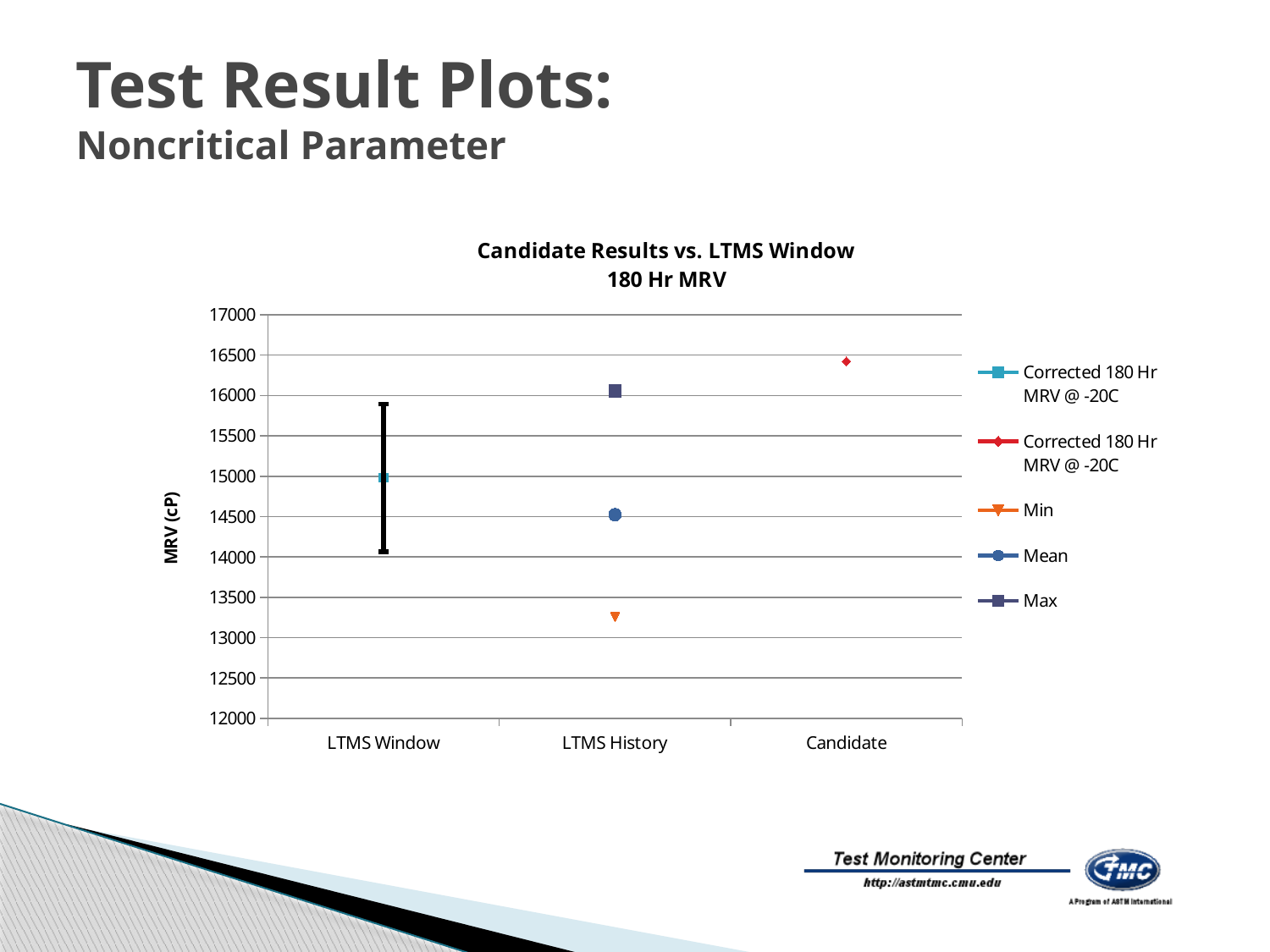
Which is larger, the Candidate value or the Max value for LTMS History? Candidate Is the Max value for LTMS History greater or less than 15500? greater Is the Mean value for LTMS History greater or less than 15000? less Is the Corrected 180 Hr MRV @ -20C value for LTMS Window greater or less than 15500? less Which is larger, the Mean value or the Min value for LTMS History? Mean How many categories are shown on the x axis? 3 Which category has the highest plotted point on the chart? Candidate What is the title of the chart? Candidate Results vs. LTMS Window 180 Hr MRV How many series does the legend list? 5 What is the label of the y axis? MRV (cP)